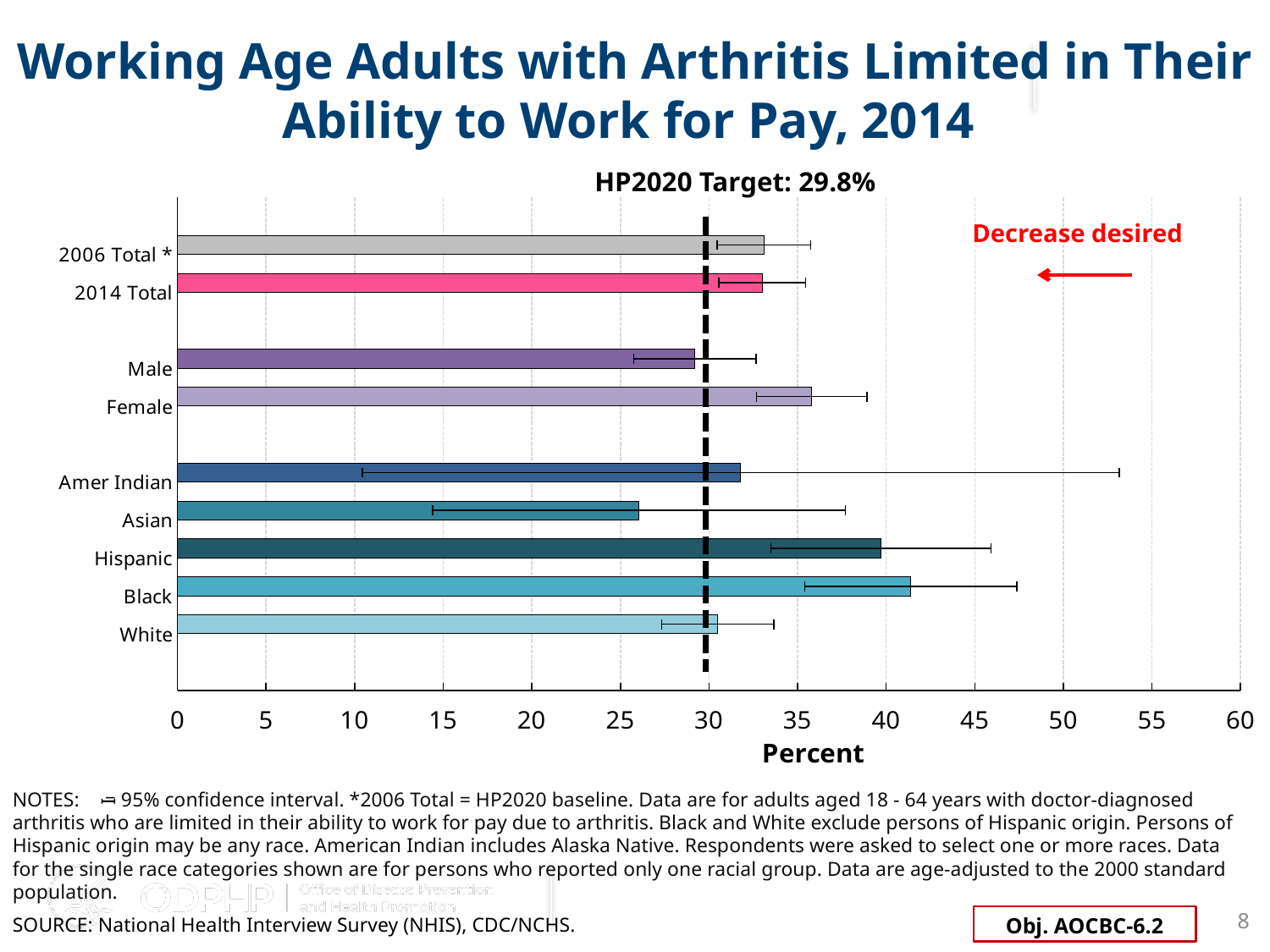
Is the value for Hispanic greater or less than 35? greater How many categories (bars) are plotted in the chart? 9 What is the label of the x axis? Percent Is the value for White greater or less than 35? less Which category has the lowest value in the chart? Asian Is the value for Female greater or less than 30? greater Which is larger, the value for Female or the value for Male? Female What is the HP2020 target shown above the chart? 29.8% What kind of chart is shown on the slide? bar chart Which is larger, the value for Hispanic or the value for Asian? Hispanic